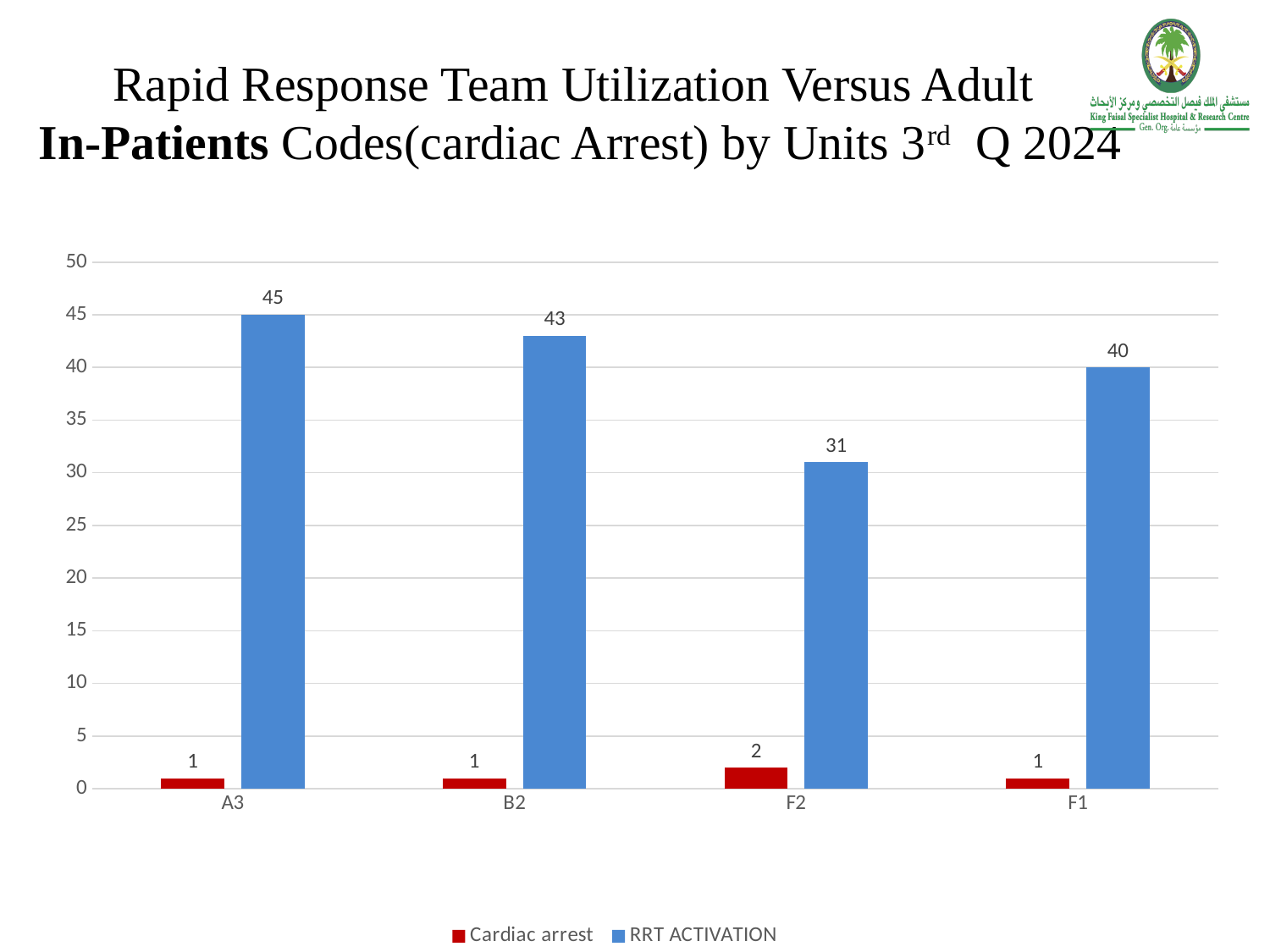
What is the Cardiac arrest value for unit F2? 2 What is the RRT ACTIVATION value for unit A3? 45 What is the RRT ACTIVATION value for unit F1? 40 Which is larger, the RRT ACTIVATION value for B2 or for F1? B2 How many units are shown on the x axis? 4 Is the RRT ACTIVATION value for F2 greater or less than 35? less Which unit has the highest Cardiac arrest value? F2 What kind of chart is shown on the slide? bar chart Which unit has the highest RRT ACTIVATION value? A3 What is the difference between the RRT ACTIVATION values for A3 and F2? 14 How many series does the legend list? 2 Which unit has the lowest RRT ACTIVATION value? F2